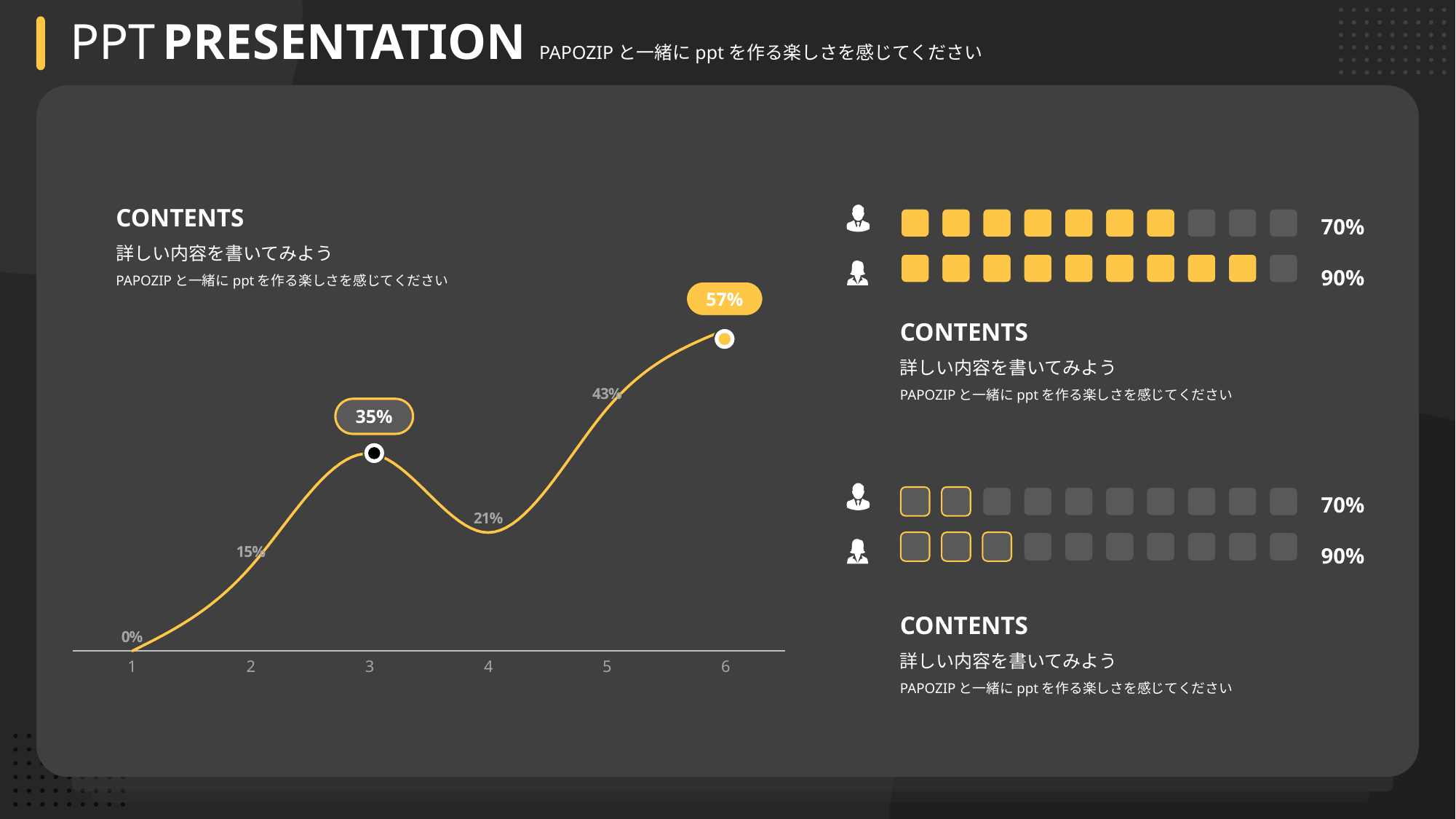
In the line chart, what is the value at point 3? 35% In the line chart, what is the difference between the values at point 5 and point 4? 22% In the line chart, what is the difference between the values at point 6 and point 3? 22% How many data points are plotted in the line chart? 6 In the line chart, which x-axis point has the lowest value? 1 In the line chart, does the value rise or fall from point 3 to point 4? fall In the line chart, what is the value at point 6? 57% What kind of chart is shown on the left side of the slide? line chart In the line chart, what is the value at point 4? 21% In the line chart, which is larger, the value at point 3 or the value at point 4? point 3 In the line chart, which x-axis point has the highest value? 6 In the line chart, what is the value at point 2? 15%